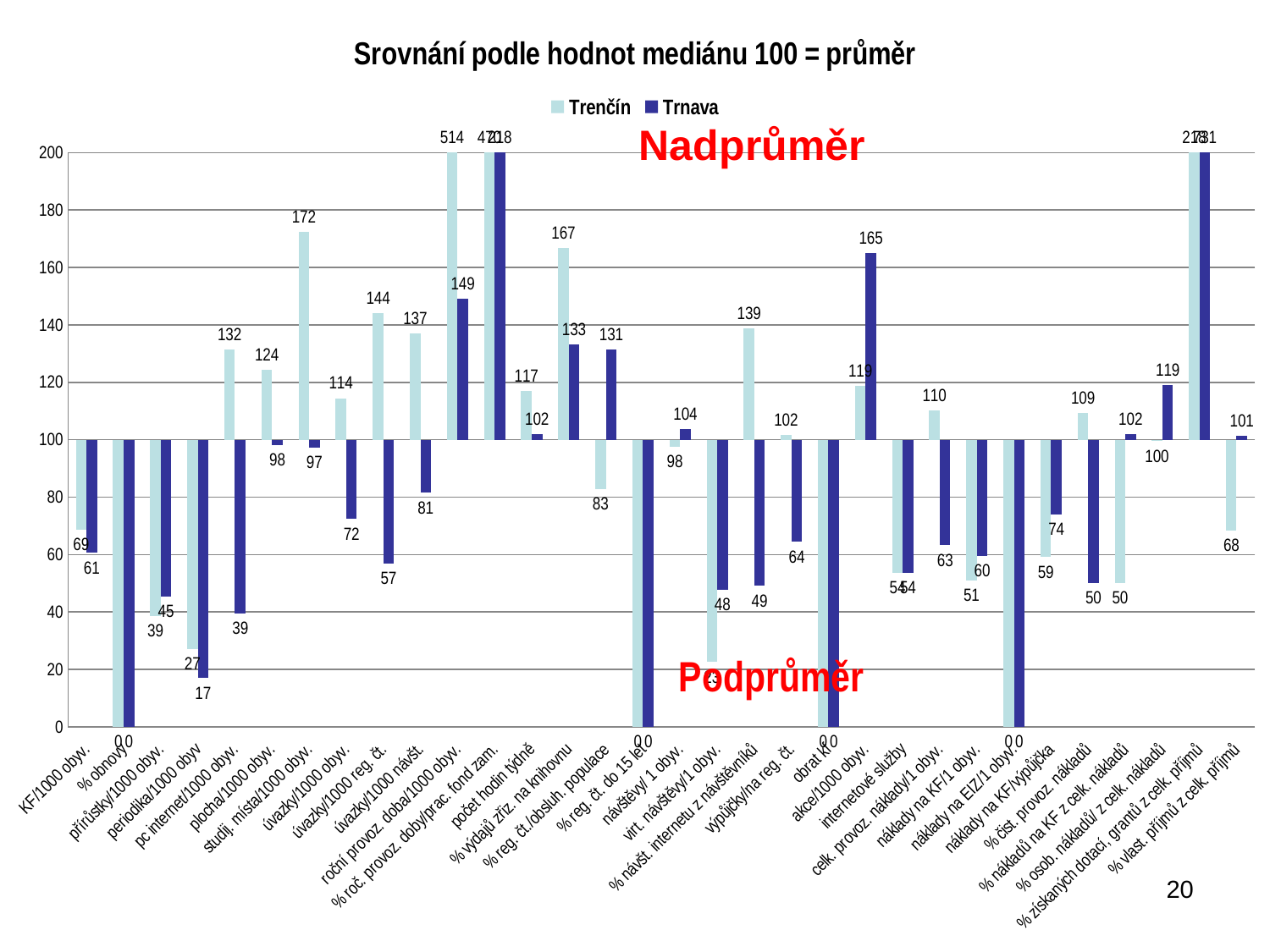
What is the difference between the Trnava and Trenčín values for akce/1000 obyv.? 46 Is the Trenčín value for virt. návštěvy/1 obyv. greater or less than 40? less What is the Trenčín value for % návšt. internetu z návštěvníků? 139 Which category has the highest Trenčín value? roční provoz. doba/1000 obyv. What is the difference between the Trenčín and Trnava values for úvazky/1000 reg. čt.? 87 What is the Trnava value for periodika/1000 obyv? 17 What kind of chart is shown on the slide? bar chart For % reg. čt./obsluh. populace, which series has the larger value, Trenčín or Trnava? Trnava What is the Trenčín value for studij. místa/1000 obyv.? 172 What is the Trenčín value for roční provoz. doba/1000 obyv.? 514 How many series does the legend list? 2 What is the Trnava value for akce/1000 obyv.? 165